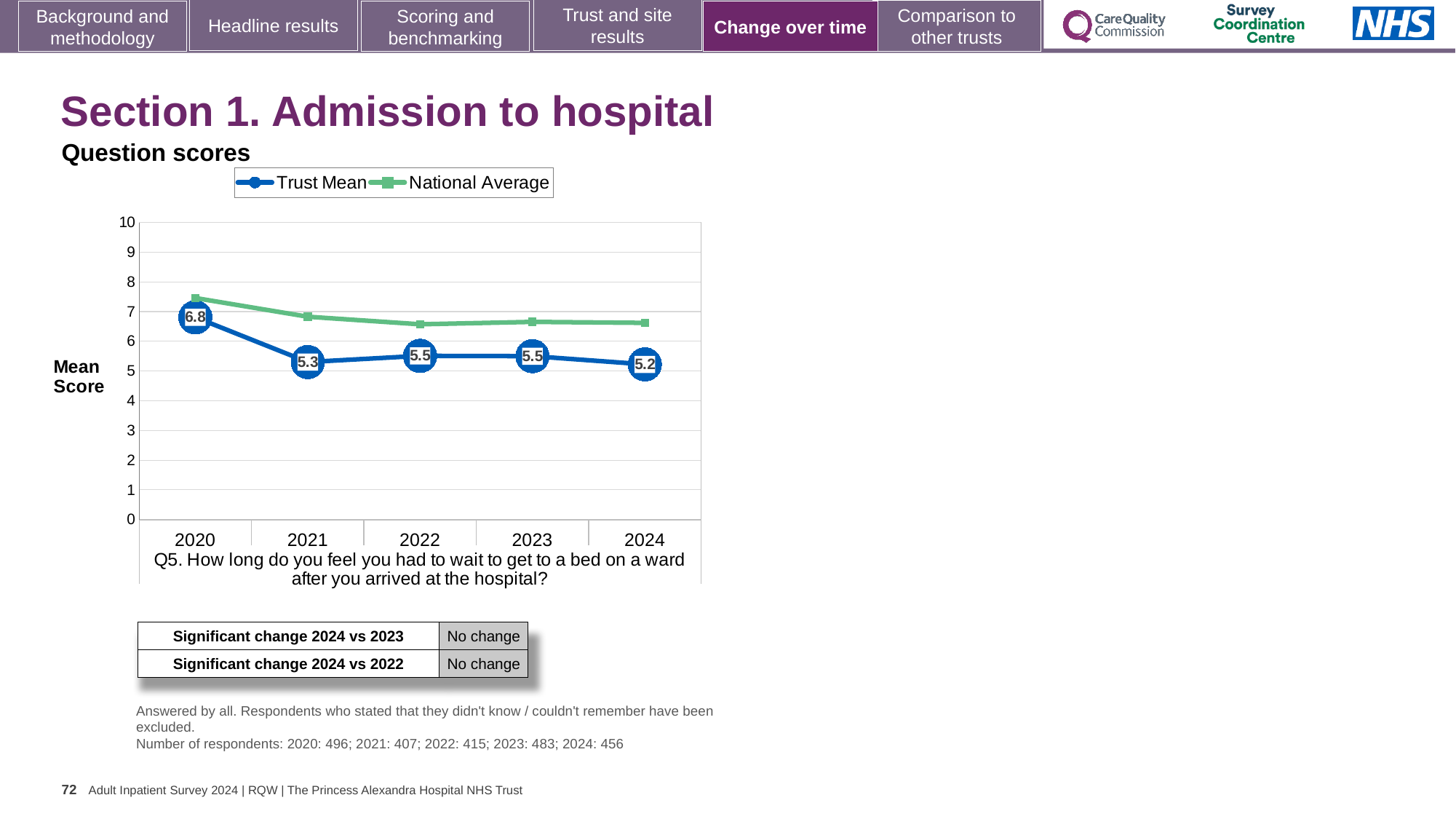
What is the Trust Mean score for 2024? 5.2 How many years are shown on the x axis? 5 In which year is the Trust Mean highest? 2020 How many series does the legend list? 2 What kind of chart is shown? Line chart Is the National Average for 2020 greater or less than 7? greater Is the National Average for 2022 greater or less than 7? less What is the Trust Mean score for 2021? 5.3 What is the difference between the Trust Mean in 2020 and in 2024? 1.6 In which year is the Trust Mean lowest? 2024 What is the Trust Mean score for 2020? 6.8 Which is larger, the Trust Mean in 2021 or in 2022? 2022